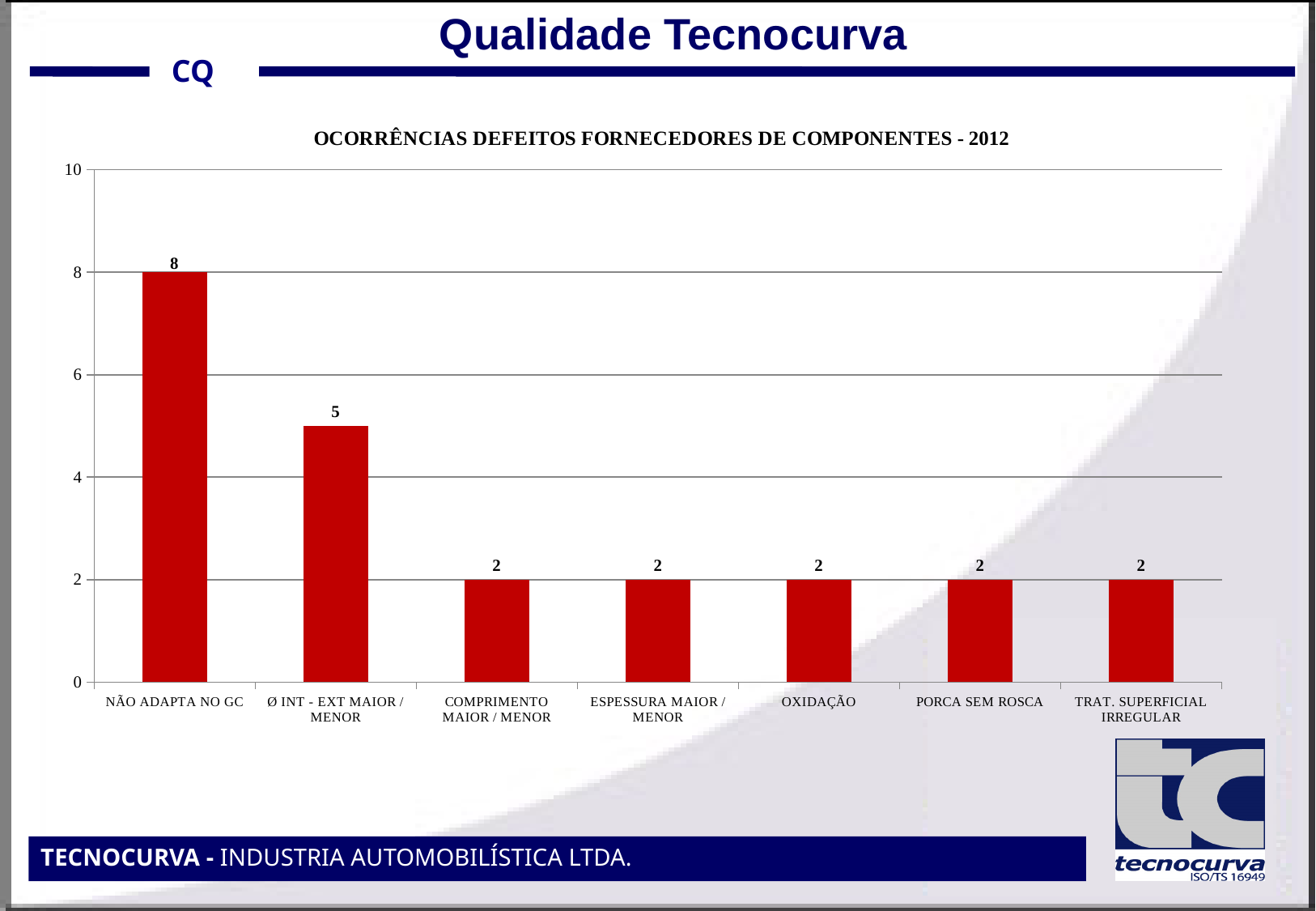
What is the value for Ø INT - EXT MAIOR / MENOR? 5 What is the value for OXIDAÇÃO? 2 What is the value for NÃO ADAPTA NO GC? 8 Which is larger, the value for Ø INT - EXT MAIOR / MENOR or the value for PORCA SEM ROSCA? Ø INT - EXT MAIOR / MENOR What kind of chart is shown on the slide? bar chart How many categories are shown on the x axis? 7 What is the title of the chart? OCORRÊNCIAS DEFEITOS FORNECEDORES DE COMPONENTES - 2012 What is the difference between the values for NÃO ADAPTA NO GC and Ø INT - EXT MAIOR / MENOR? 3 Do the values rise or fall from left to right along the x axis? fall How many categories have a value of 2? 5 Is the value for NÃO ADAPTA NO GC greater or less than 6? greater Which category has the highest value? NÃO ADAPTA NO GC